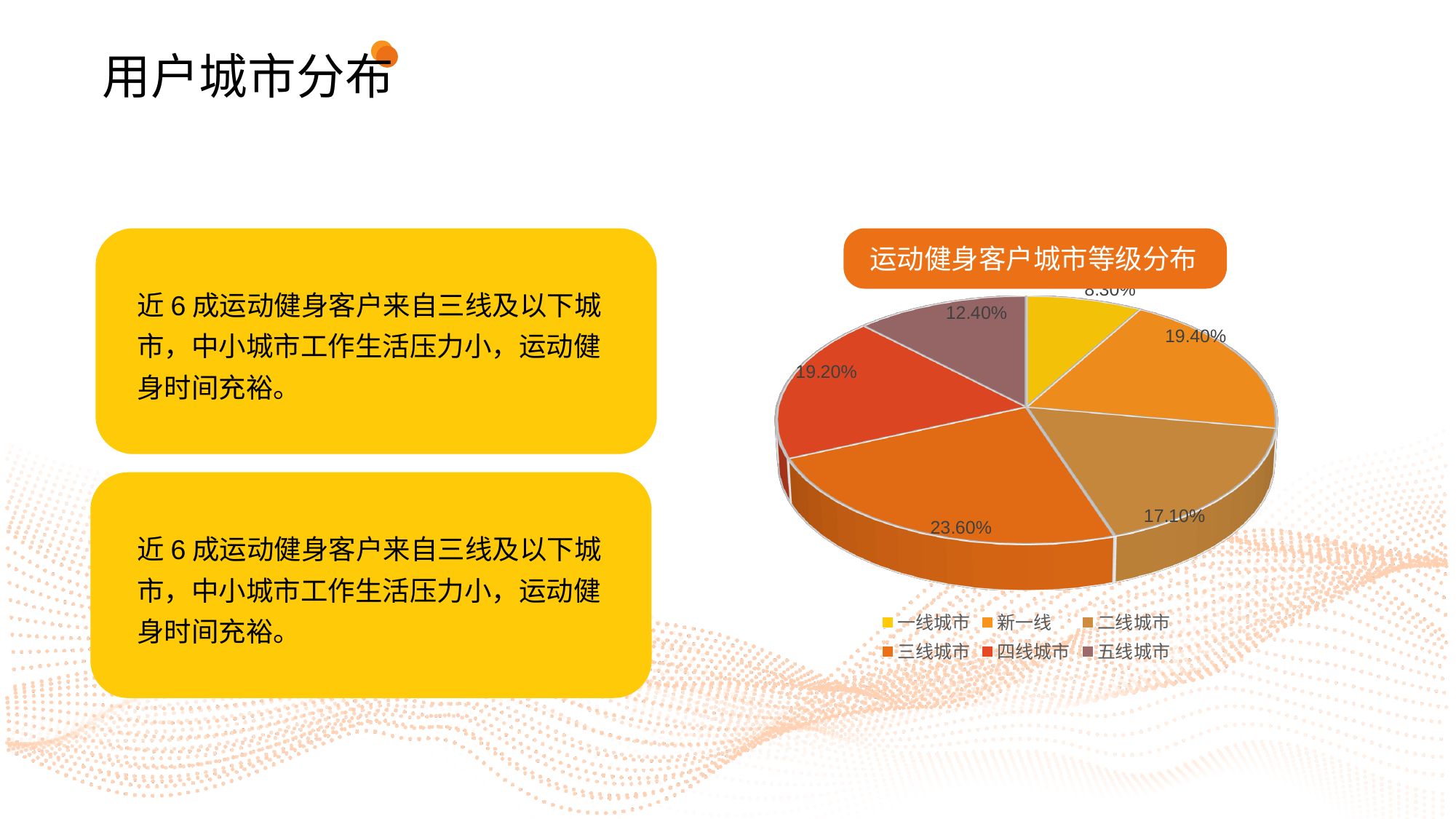
What is the value for 四线城市? 19.20% Which category has the smallest share of the pie? 一线城市 Which is larger, the share of 五线城市 or the share of 二线城市? 二线城市 What is the title of the chart? 运动健身客户城市等级分布 What kind of chart is shown on the slide? Pie chart What is the value for 新一线? 19.40% How many categories does the pie chart have? 6 What is the value for 五线城市? 12.40% What share of the pie does 三线城市 account for? 23.60% What is the difference between the shares of 三线城市 and 二线城市? 6.50% What is the value for 二线城市? 17.10% Which category has the largest share of the pie? 三线城市